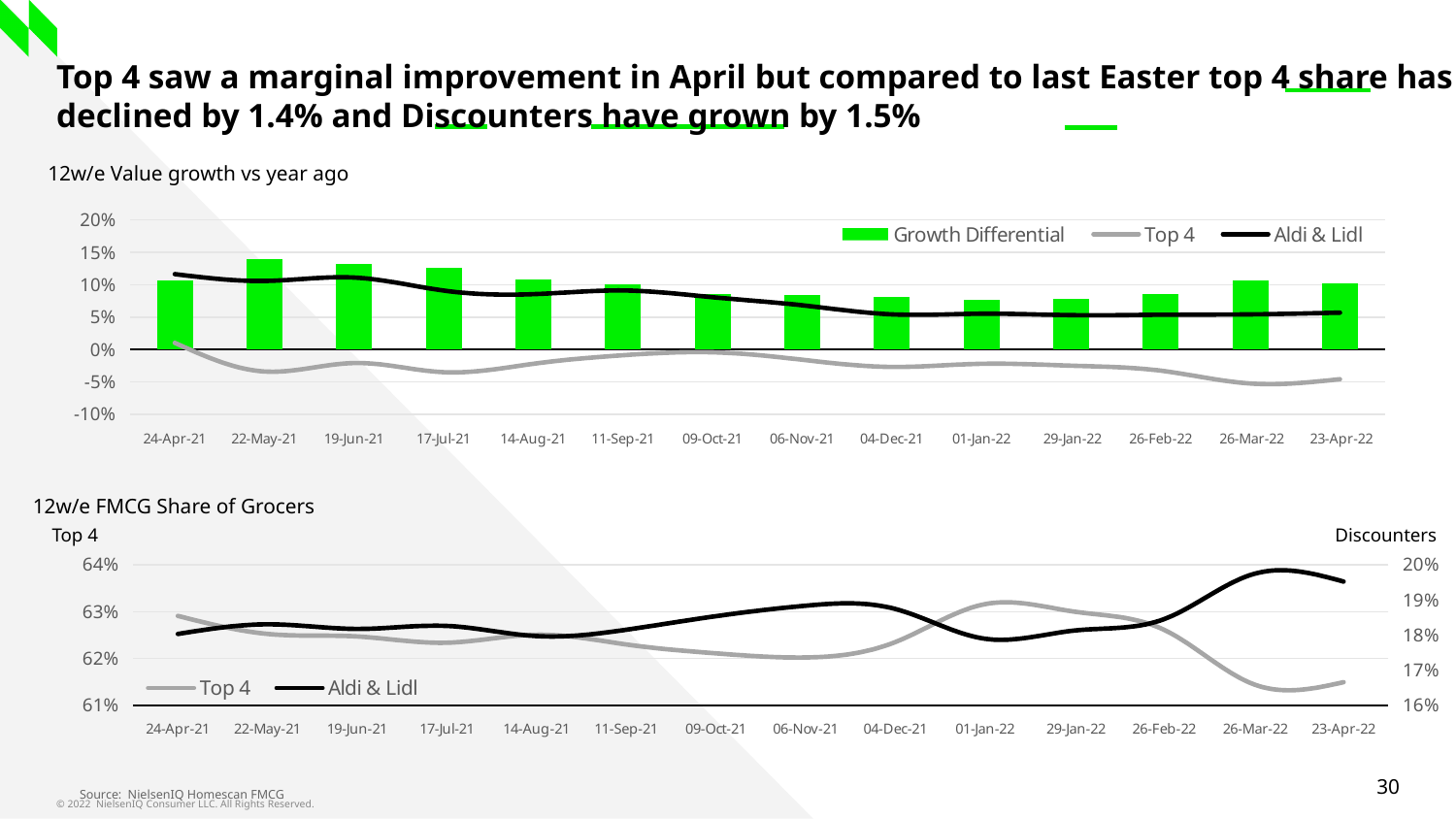
In the top chart (12w/e Value growth vs year ago), is the Top 4 value for 26-Mar-22 greater or less than 0%? less In the top chart (12w/e Value growth vs year ago), does the Aldi & Lidl line generally rise or fall from 24-Apr-21 to 23-Apr-22? fall In the top chart (12w/e Value growth vs year ago), what kind of chart is it? Combination bar and line chart In the top chart (12w/e Value growth vs year ago), which is higher at 24-Apr-21: the Top 4 line or the Aldi & Lidl line? Aldi & Lidl In the bottom chart (12w/e FMCG Share of Grocers), what is the title of the right-hand axis? Discounters In the top chart (12w/e Value growth vs year ago), is the Growth Differential for 22-May-21 greater or less than 10%? greater In the top chart (12w/e Value growth vs year ago), how many series does the legend list? 3 In the top chart (12w/e Value growth vs year ago), how many dates are shown on the x axis? 14 In the bottom chart (12w/e FMCG Share of Grocers), how many series does the legend list? 2 In the bottom chart (12w/e FMCG Share of Grocers), at which date does the Aldi & Lidl line reach its highest point? 26-Mar-22 In the top chart (12w/e Value growth vs year ago), at which date is the Growth Differential bar highest? 22-May-21 In the bottom chart (12w/e FMCG Share of Grocers), is the Top 4 share for 23-Apr-22 greater or less than 62%? less